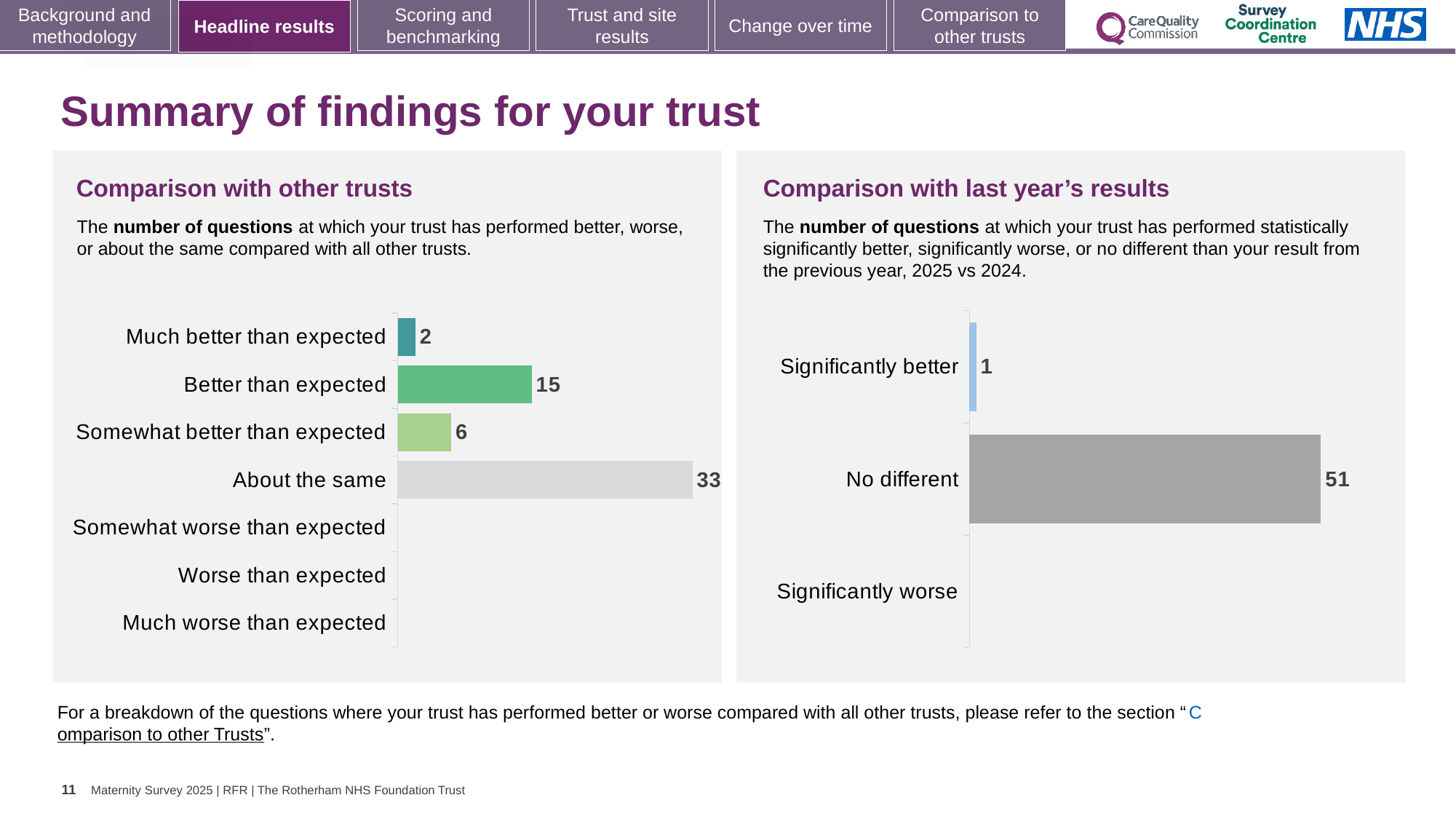
In the 'Comparison with last year's results' chart, what is the difference between 'No different' and 'Significantly better'? 50 How many categories are shown on the 'Comparison with last year's results' chart? 3 What type of chart is the 'Comparison with last year's results' chart? Bar chart In the 'Comparison with other trusts' chart, which is larger: 'Somewhat better than expected' or 'Much better than expected'? Somewhat better than expected In the 'Comparison with other trusts' chart, what is the difference between 'Better than expected' and 'Somewhat better than expected'? 9 How many categories are listed on the 'Comparison with other trusts' chart? 7 In the 'Comparison with other trusts' chart, what is the value for 'Much better than expected'? 2 In the 'Comparison with last year's results' chart, what is the value for 'No different'? 51 In the 'Comparison with other trusts' chart, which category has the highest value? About the same In the 'Comparison with other trusts' chart, how many questions were 'Better than expected'? 15 In the 'Comparison with last year's results' chart, what is the value for 'Significantly better'? 1 In the 'Comparison with other trusts' chart, what is the value for 'About the same'? 33